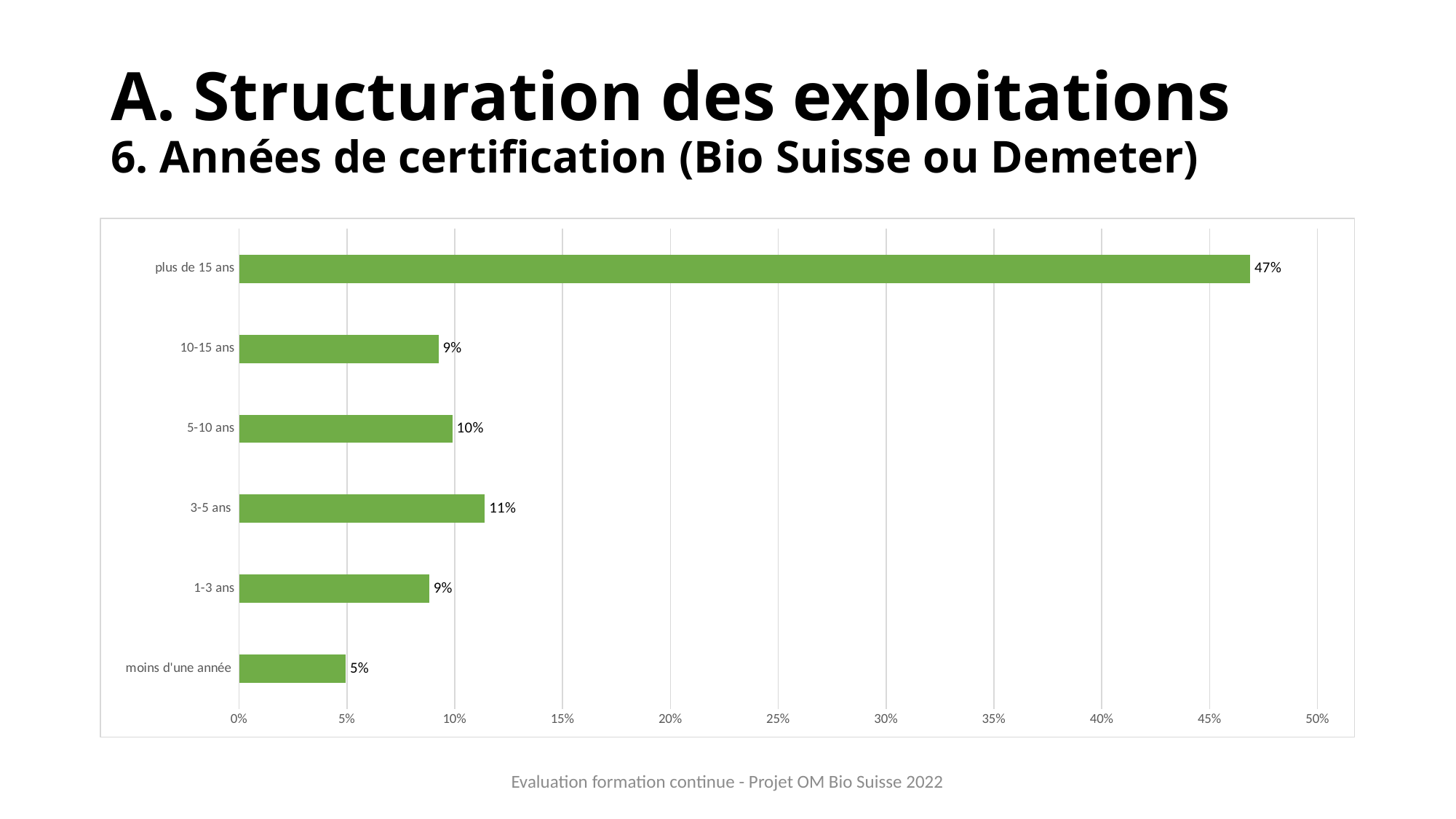
How many categories are shown in the chart? 6 What kind of chart is shown on the slide? bar chart What is the value for 'moins d'une année'? 5% What is the value for '3-5 ans'? 11% What colour are the bars in the chart? green What is the difference between the values for 'plus de 15 ans' and '3-5 ans'? 36% Is the value for 'plus de 15 ans' greater or less than 45%? greater Which category has the highest value? plus de 15 ans Which is larger, the value for '3-5 ans' or the value for '1-3 ans'? 3-5 ans Which category has the lowest value? moins d'une année What is the value for 'plus de 15 ans'? 47% What is the value for '5-10 ans'? 10%